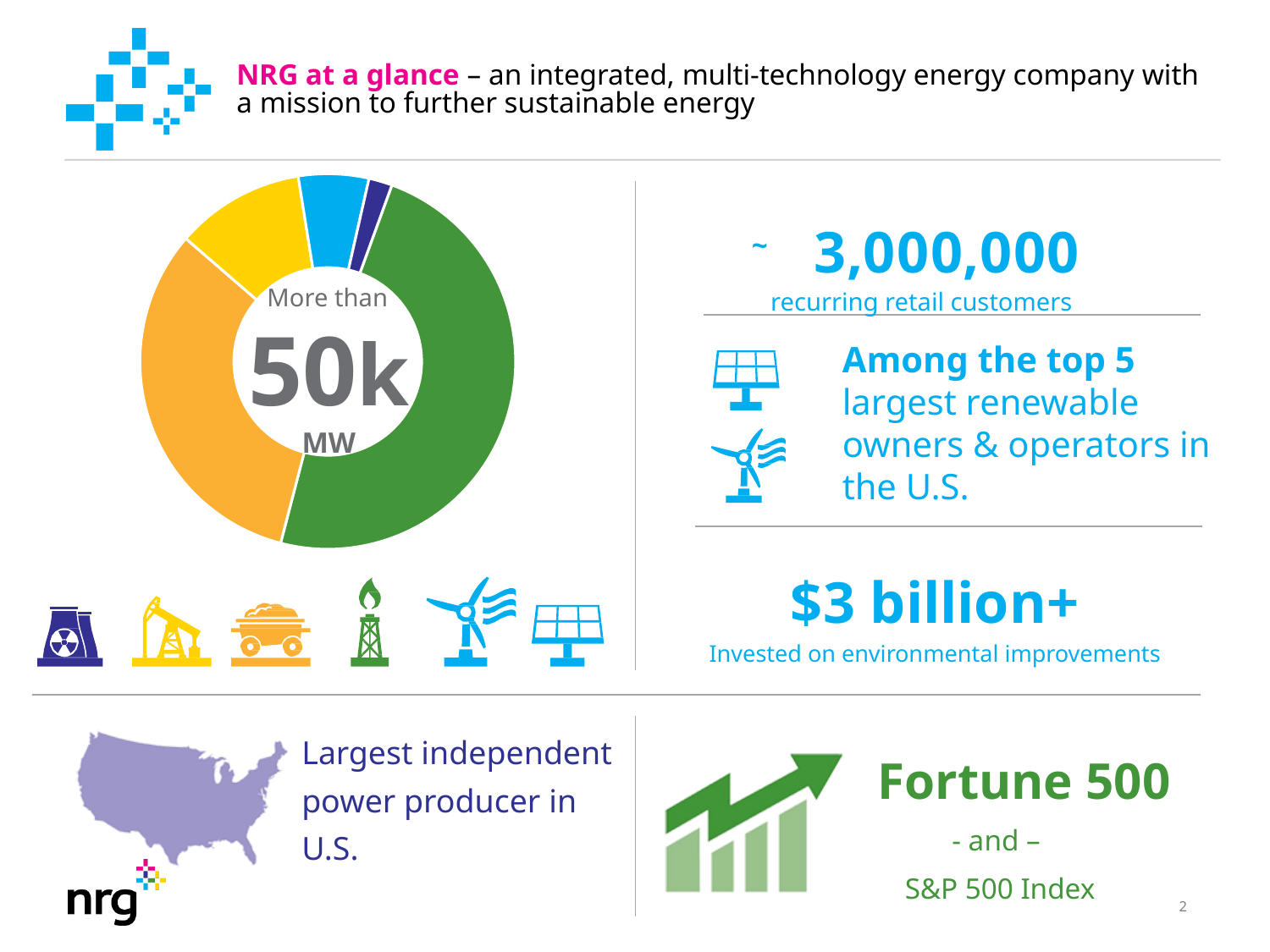
Which colour slice of the donut chart is the smallest? Dark blue What text is printed in the centre of the donut chart? More than 50k MW In the donut chart, is the orange slice larger or smaller than the light blue slice? Larger Which colour slice of the donut chart is the largest? Green Does the donut chart include a legend listing its categories? No How many slices does the donut chart contain? 5 What kind of chart is shown on the left side of the slide? Donut (pie) chart In the donut chart, is the green slice larger or smaller than the yellow slice? Larger